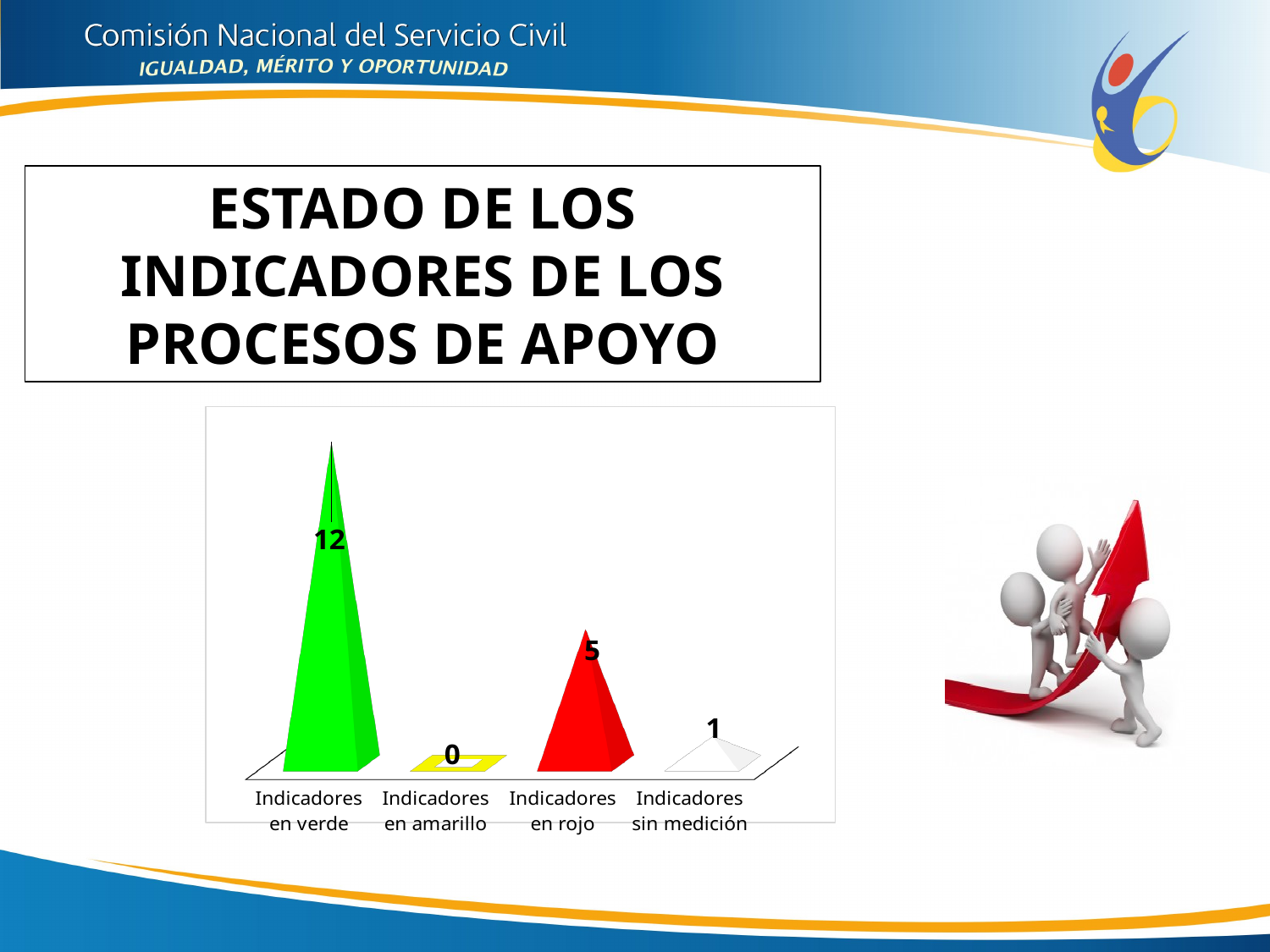
What colour is the bar for Indicadores en rojo? Red Which category has the lowest value? Indicadores en amarillo What kind of chart is shown on the slide? Bar chart What is the value for Indicadores en verde? 12 What is the difference between the values for Indicadores en verde and Indicadores en rojo? 7 What is the value for Indicadores en rojo? 5 Which category has the highest value? Indicadores en verde How many categories are shown on the x axis? 4 What is the difference between the values for Indicadores en rojo and Indicadores sin medición? 4 Which is larger, the value for Indicadores en rojo or Indicadores sin medición? Indicadores en rojo What is the value for Indicadores sin medición? 1 What is the value for Indicadores en amarillo? 0